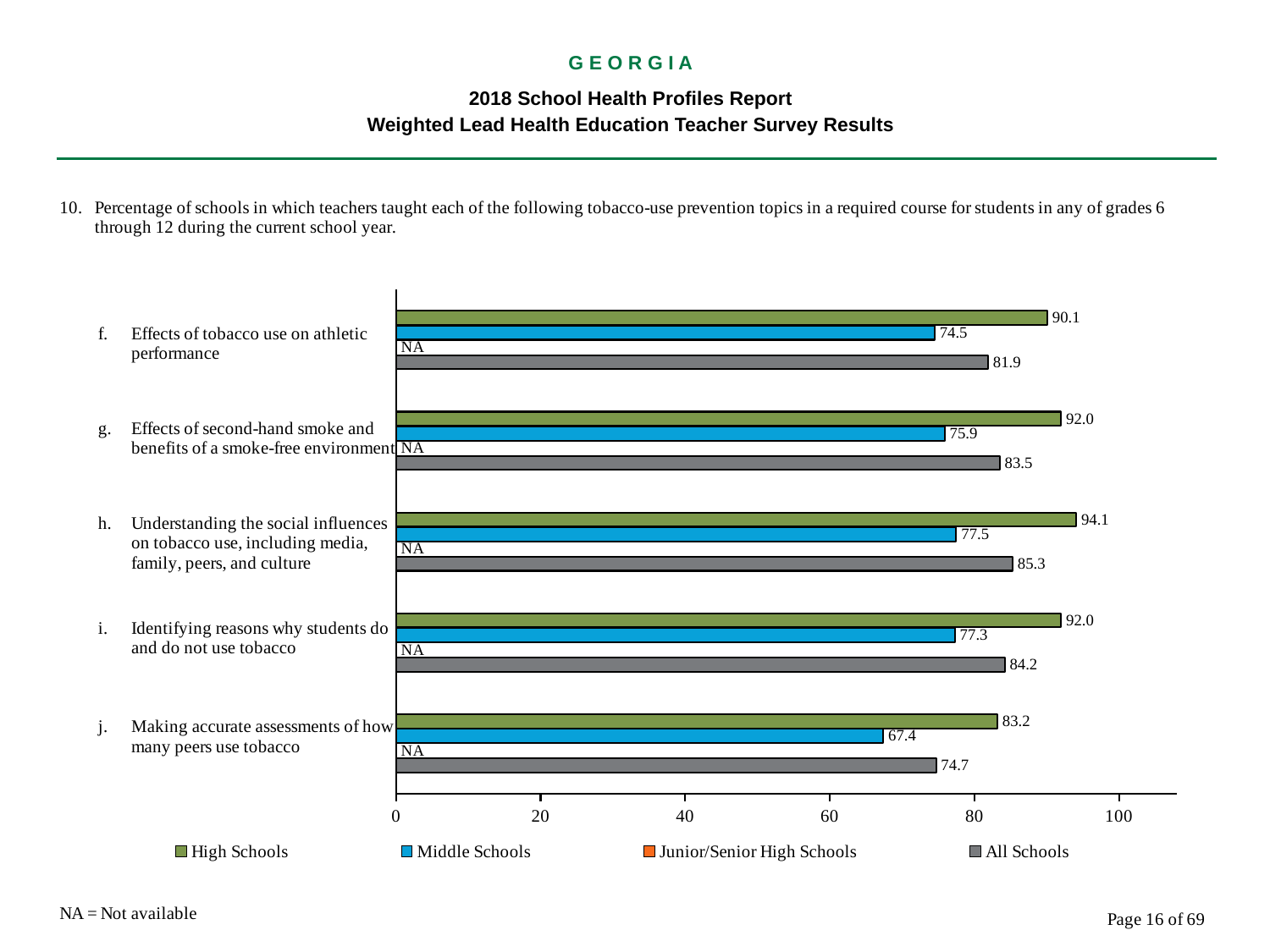
Is the Middle Schools value for 'Understanding the social influences on tobacco use' greater or less than 80? less Which topic has the highest High Schools value? Understanding the social influences on tobacco use, including media, family, peers, and culture What is the All Schools value for 'Effects of second-hand smoke and benefits of a smoke-free environment'? 83.5 How many series does the legend list? 4 What kind of chart is shown on the slide? bar chart What is the High Schools value for 'Understanding the social influences on tobacco use, including media, family, peers, and culture'? 94.1 What is the difference between the High Schools and Middle Schools values for 'Effects of tobacco use on athletic performance'? 15.6 How many tobacco-use prevention topics are shown on the chart? 5 Which topic has the lowest Middle Schools value? Making accurate assessments of how many peers use tobacco What is shown for Junior/Senior High Schools for 'Effects of tobacco use on athletic performance'? NA Which is larger: the All Schools value for 'Identifying reasons why students do and do not use tobacco' or the All Schools value for 'Making accurate assessments of how many peers use tobacco'? Identifying reasons why students do and do not use tobacco What is the Middle Schools value for 'Making accurate assessments of how many peers use tobacco'? 67.4